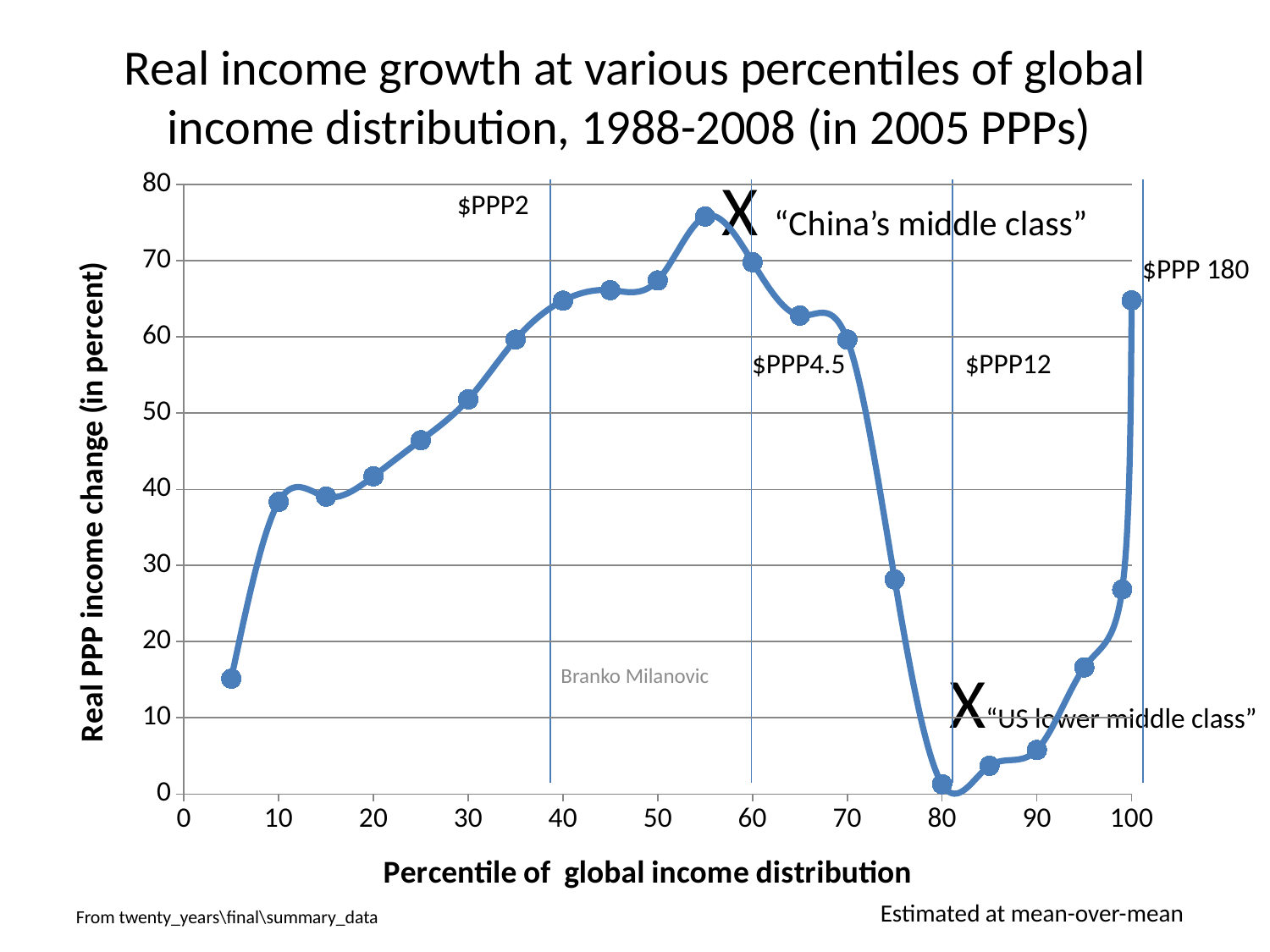
At which percentile of the global income distribution is the real PPP income change highest? 55 Is the real PPP income change at the 75th percentile greater or less than 40? less Is the real PPP income change at the 5th percentile greater or less than 20? less What kind of chart is shown on the slide? line chart What is the title of the vertical axis? Real PPP income change (in percent) Is the real PPP income change at the 55th percentile greater or less than 70? greater Does the real PPP income change rise or fall as the percentile increases from 5 to 55? rise Which has the larger real PPP income change, the 55th percentile or the 60th percentile? 55th percentile At which percentile of the global income distribution is the real PPP income change lowest? 80 Which has the larger real PPP income change, the 85th percentile or the 95th percentile? 95th percentile